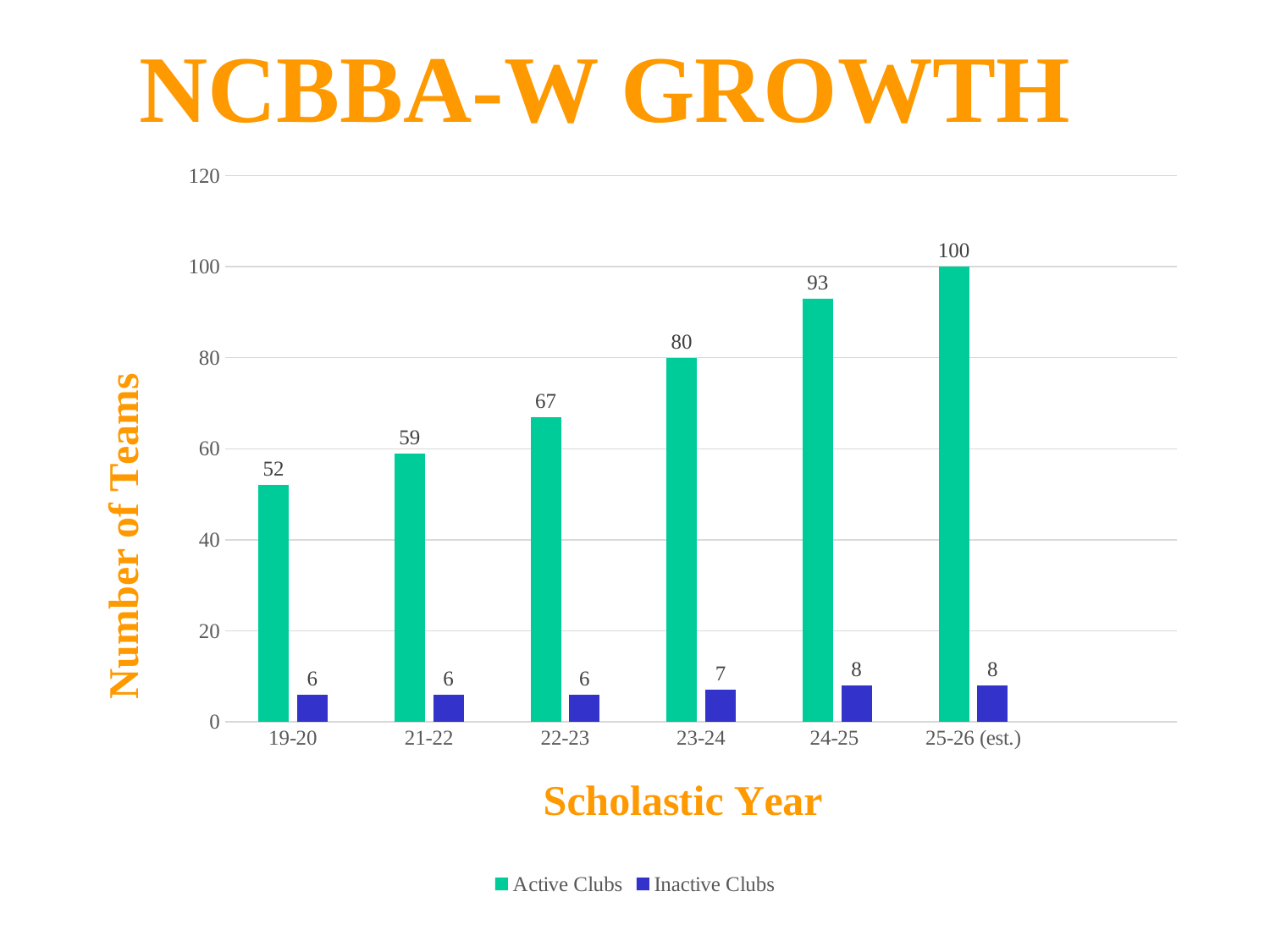
Which scholastic year has the lowest number of Active Clubs? 19-20 What is the estimated number of Active Clubs in 25-26 (est.)? 100 What is the number of Inactive Clubs in 24-25? 8 Is the number of Active Clubs in 24-25 greater or less than 80? greater Which is larger: Active Clubs in 22-23 or Active Clubs in 21-22? 22-23 Do the Active Clubs values rise or fall from 19-20 to 25-26 (est.)? rise How many series does the legend list? 2 Which scholastic year has the highest number of Active Clubs? 25-26 (est.) What is the difference in Active Clubs between 24-25 and 19-20? 41 How many scholastic years are shown on the x axis? 6 What is the number of Active Clubs in 23-24? 80 What kind of chart is shown on the slide? bar chart